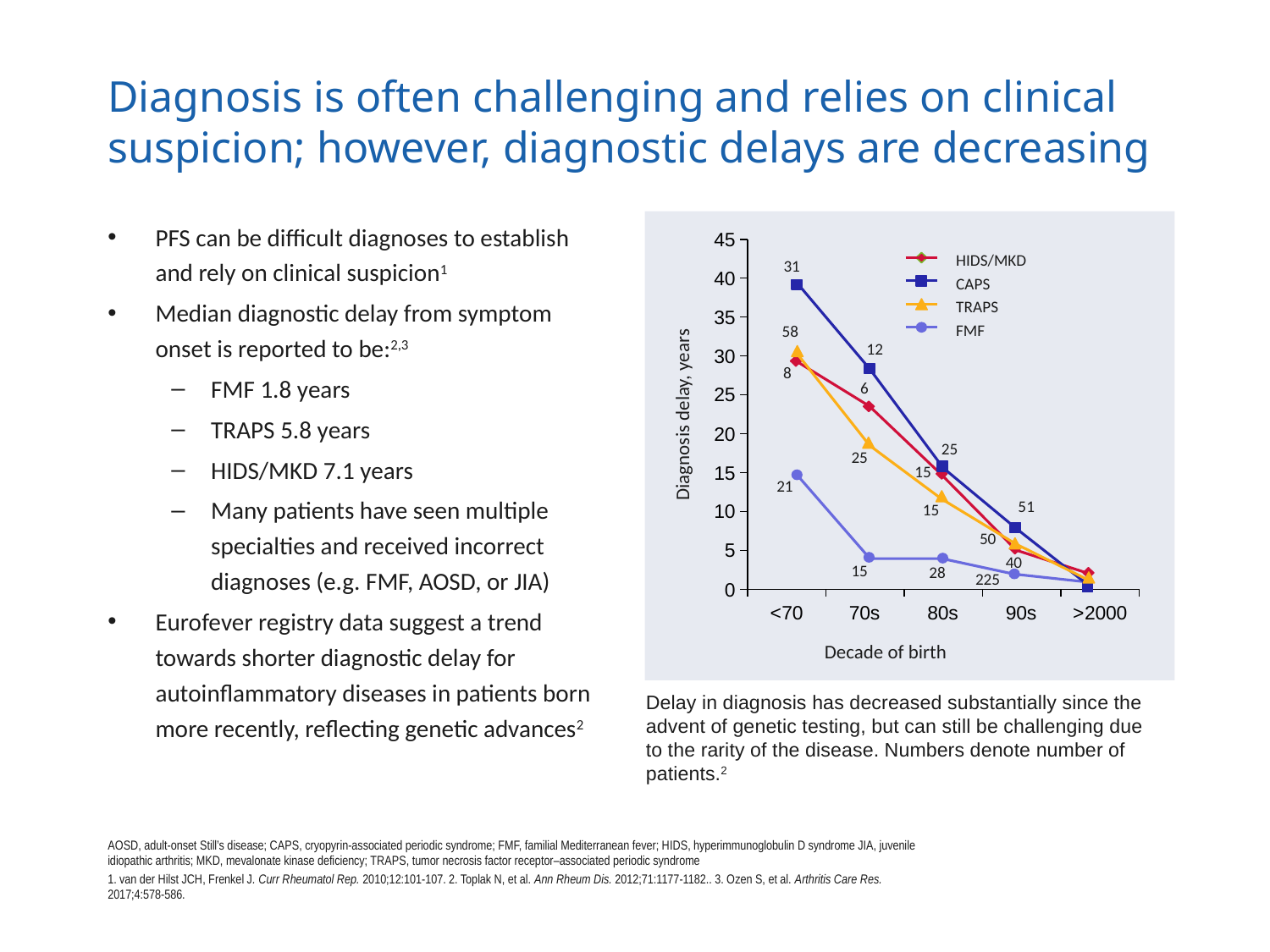
Is the diagnosis delay for HIDS/MKD in the 70s category greater or less than 20 years? greater For patients born in the 80s, which has the larger diagnosis delay, TRAPS or FMF? TRAPS Does the diagnosis delay for CAPS rise or fall across the decades of birth from <70 to >2000? fall Is the diagnosis delay for CAPS in the <70 category greater or less than 35 years? greater How many decade-of-birth categories are shown on the x axis? 5 For patients born in the 70s, which has the larger diagnosis delay, CAPS or FMF? CAPS Which series has the lowest diagnosis delay for patients born <70? FMF What is the title of the x axis of the chart? Decade of birth Is the diagnosis delay for FMF in the <70 category greater or less than 20 years? less What kind of chart is shown on the slide? line chart How many series does the chart legend list? 4 Which series has the highest diagnosis delay for patients born <70? CAPS